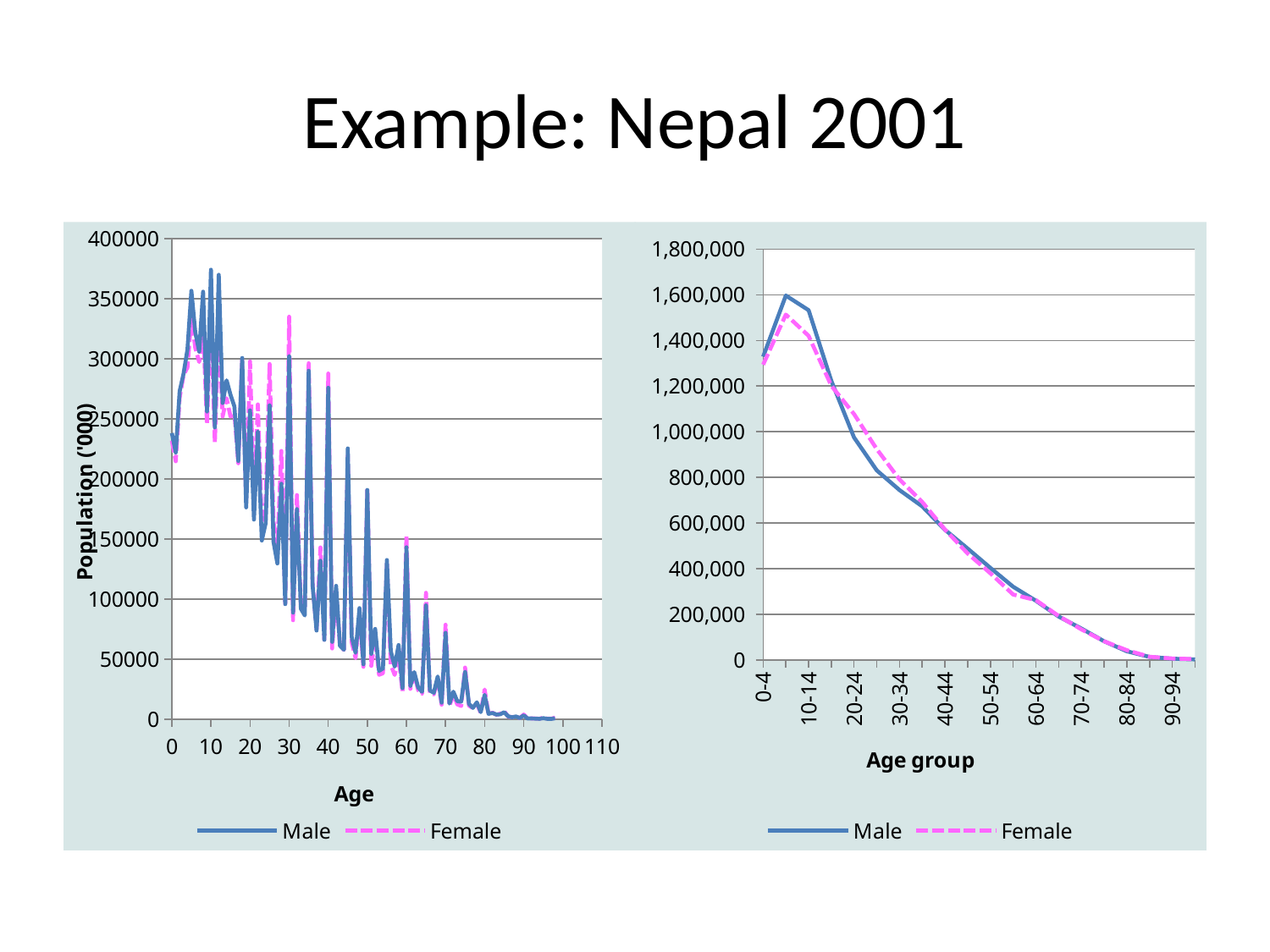
In the right-hand chart, what is the title of the x axis? Age group In the right-hand chart, is the Male value for the 10-14 age group greater or less than 1,400,000? greater In the right-hand chart, which series has the higher value for the 10-14 age group, Male or Female? Male In the left-hand chart, is the Female value at age 30 greater or less than 300000? greater In the right-hand chart, do the Male values generally rise or fall from the 10-14 age group to the 90-94 age group? fall In the left-hand chart, is the Male value at age 10 greater or less than 350000? greater What kind of chart is the chart on the left of the slide? line chart How many series does the legend of the right-hand chart list? 2 What kind of chart is the chart on the right of the slide? line chart In the left-hand chart, what is the title of the y axis? Population ('000)